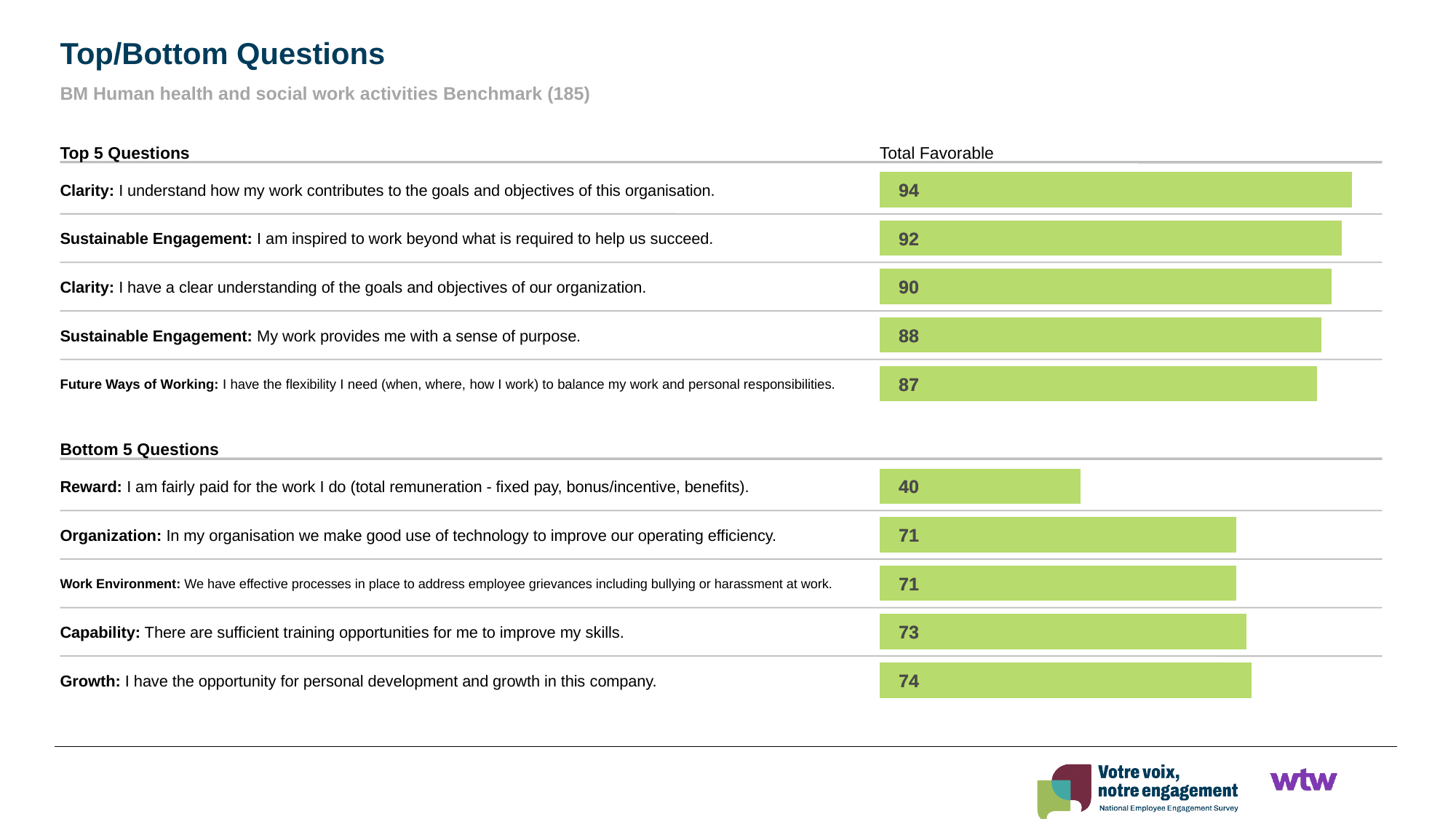
In the Bottom 5 Questions chart, what is the difference between the Total Favorable values for the Growth question and the Reward question? 34 In the Top 5 Questions chart, what is the Total Favorable value for "Clarity: I understand how my work contributes to the goals and objectives of this organisation"? 94 In the Top 5 Questions chart, what is the difference between the Total Favorable values for "Sustainable Engagement: I am inspired to work beyond what is required to help us succeed" and "Sustainable Engagement: My work provides me with a sense of purpose"? 4 How many questions are shown in the Bottom 5 Questions chart? 5 In the Top 5 Questions chart, what is the Total Favorable value for "Future Ways of Working: I have the flexibility I need (when, where, how I work) to balance my work and personal responsibilities"? 87 In the Top 5 Questions chart, which question has the highest Total Favorable value? Clarity: I understand how my work contributes to the goals and objectives of this organisation. In the Bottom 5 Questions chart, what is the Total Favorable value for "Growth: I have the opportunity for personal development and growth in this company"? 74 What is the subtitle of the slide, shown below the title "Top/Bottom Questions"? BM Human health and social work activities Benchmark (185) In the Bottom 5 Questions chart, which has a larger Total Favorable value: the Capability question or the Organization question? Capability In the Bottom 5 Questions chart, what is the Total Favorable value for "Reward: I am fairly paid for the work I do"? 40 In the Bottom 5 Questions chart, which question has the lowest Total Favorable value? Reward: I am fairly paid for the work I do (total remuneration - fixed pay, bonus/incentive, benefits). What kind of chart is used to show the Total Favorable values on this slide? Bar chart